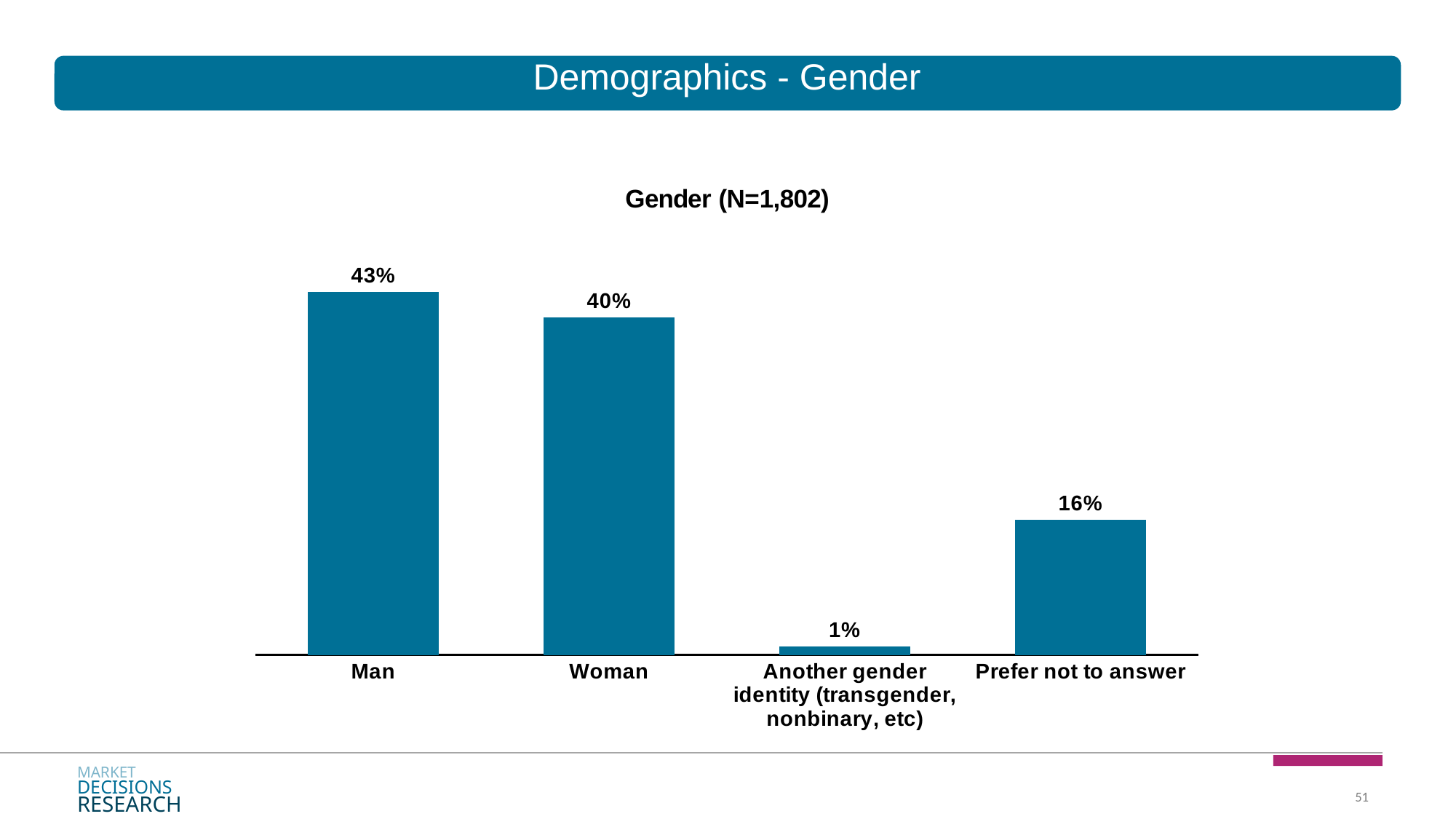
Which category has the lowest percentage? Another gender identity (transgender, nonbinary, etc) What kind of chart is shown on the slide? Bar chart Which category has the highest percentage? Man What is the difference in percentage points between Man and Woman? 3 percentage points Which is larger, the value for Prefer not to answer or the value for Another gender identity? Prefer not to answer What percentage of respondents identified as Man? 43% What percentage of respondents identified as Woman? 40% What is the sample size (N) shown in the chart title? 1,802 What is the difference in percentage points between Woman and Prefer not to answer? 24 percentage points How many categories are shown in the chart? 4 What percentage of respondents selected Another gender identity (transgender, nonbinary, etc)? 1% What percentage of respondents chose Prefer not to answer? 16%